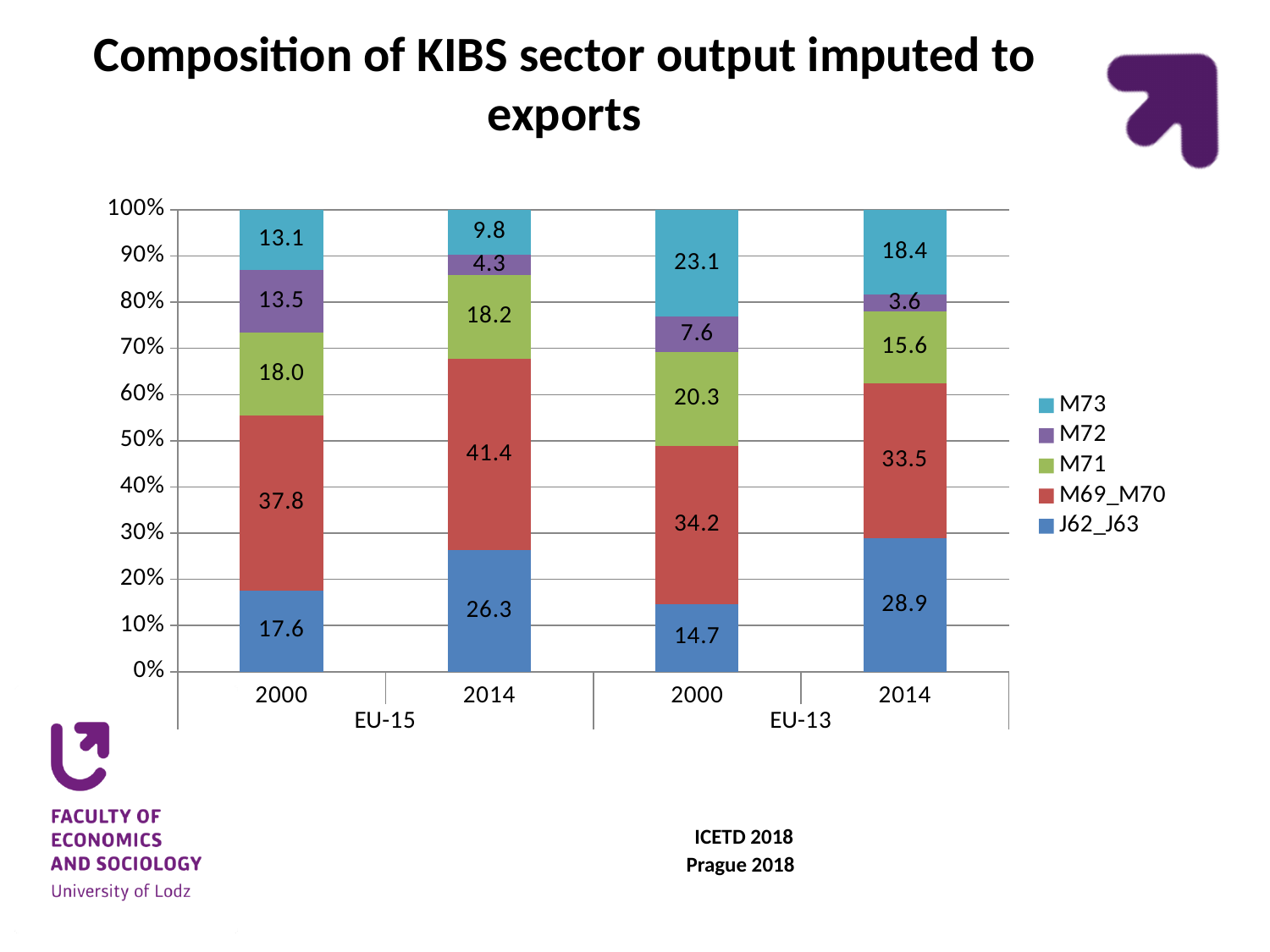
How many bars are plotted in the chart? 4 What is the value of M69_M70 for EU-15 in 2014? 41.4 What is the difference between the M69_M70 values for EU-15 in 2000 and 2014? 3.6 How many series does the legend list? 5 Which is larger, the M71 value for EU-13 in 2000 or for EU-13 in 2014? EU-13 2000 Which bar has the lowest value for M72? EU-13 2014 What kind of chart is shown on the slide? Stacked bar chart What is the value of M73 for EU-13 in 2000? 23.1 What is the value of J62_J63 for EU-13 in 2000? 14.7 What is the value of M72 for EU-13 in 2014? 3.6 Which series is shown in red in the chart? M69_M70 Which bar has the highest value for J62_J63? EU-13 2014